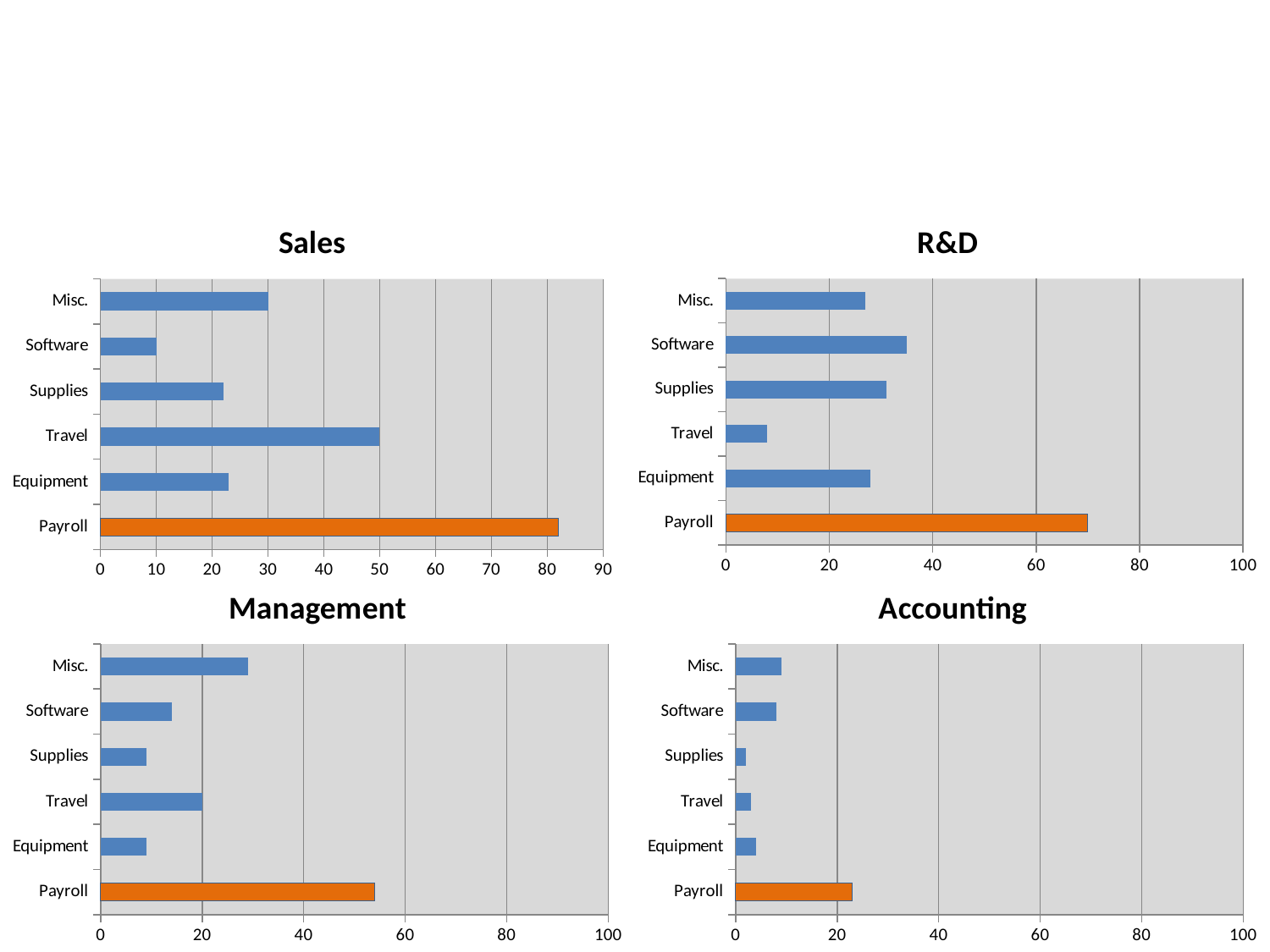
In the R&D chart, which is larger, Software or Misc.? Software How many categories are shown in the R&D chart? 6 In the Sales chart, what is the value for Travel? 50 In the Sales chart, which category has the highest value? Payroll In the Sales chart, is the value for Payroll greater or less than 80? greater In the Accounting chart, which category has the highest value? Payroll In the Accounting chart, is the value for Supplies greater or less than 10? less What kind of chart is the Sales chart? bar chart In the R&D chart, which category has the lowest value? Travel In the Sales chart, which category has the lowest value? Software